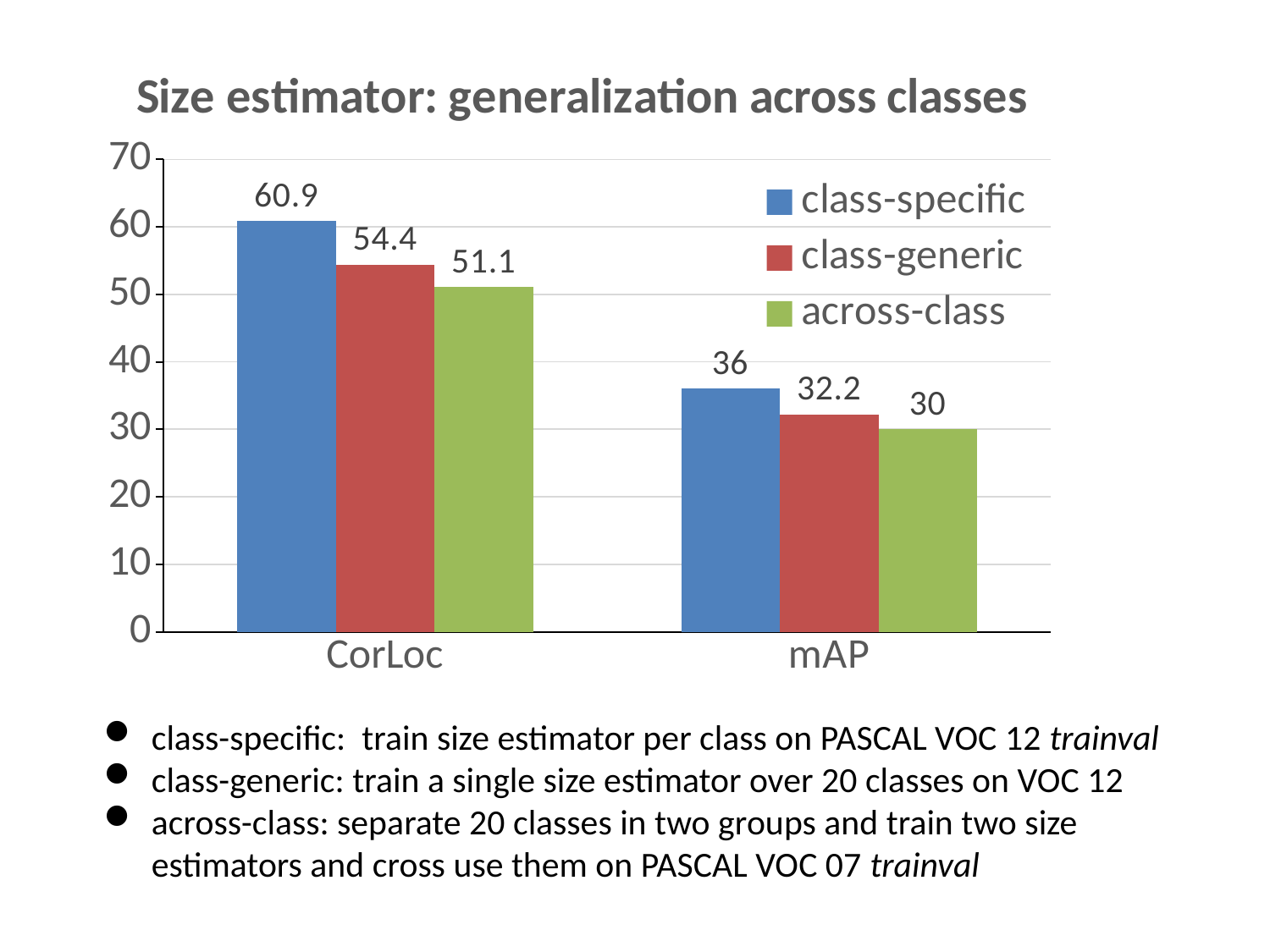
What is the title of the chart? Size estimator: generalization across classes Which is larger: the across-class value for CorLoc or the class-specific value for mAP? across-class value for CorLoc How many categories are shown on the x axis? 2 What is the difference between the class-specific and class-generic values for CorLoc? 6.5 What is the difference between the class-generic and across-class values for mAP? 2.2 Which series has the lowest value for CorLoc? across-class What is the class-generic value for CorLoc? 54.4 How many series does the legend list? 3 What kind of chart is shown on the slide? bar chart What is the across-class value for mAP? 30 What is the class-specific value for CorLoc? 60.9 Which series has the highest value for mAP? class-specific